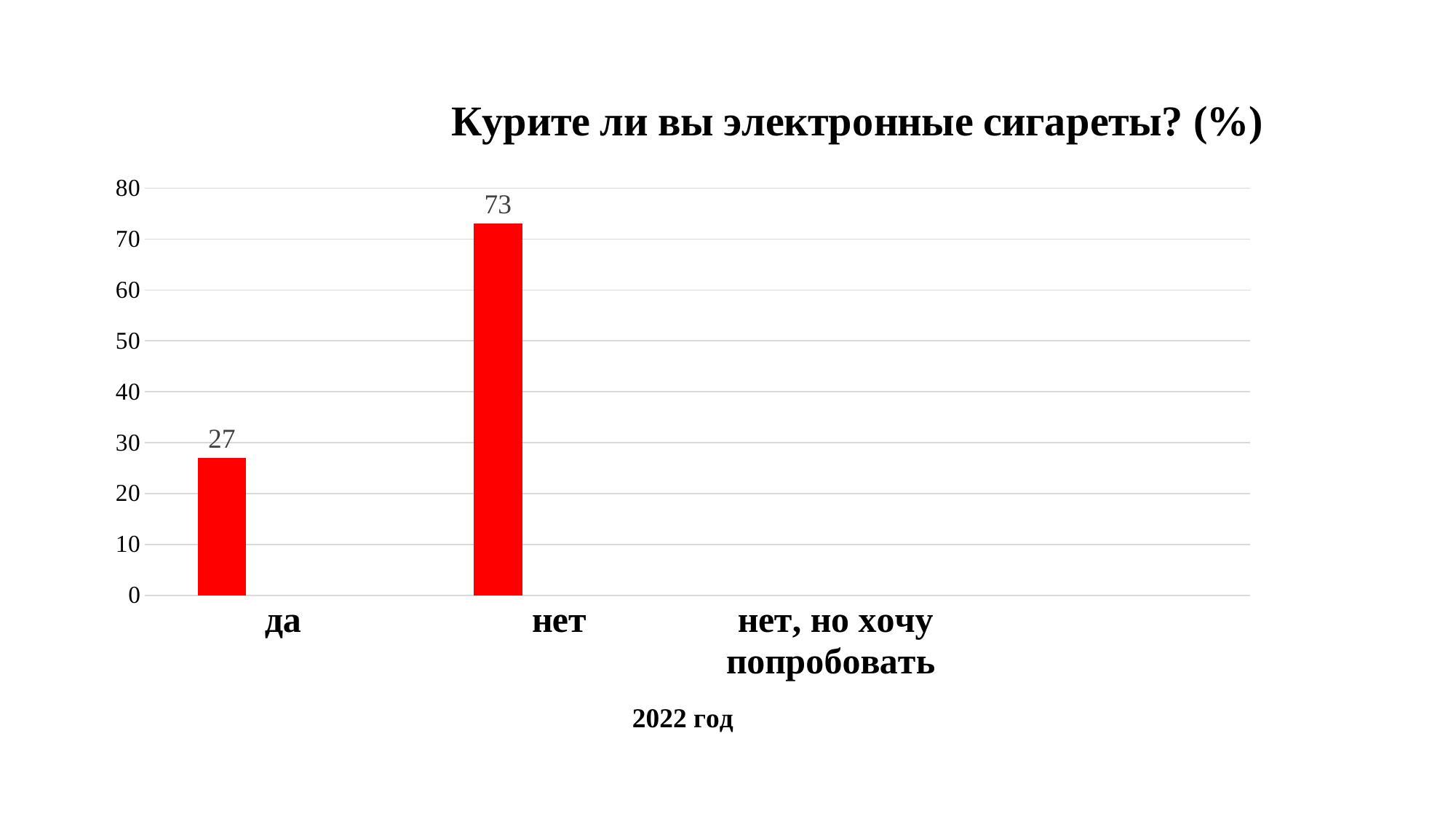
Which of the two plotted categories, "да" or "нет", has the lower value? да Which category has the highest value? нет What kind of chart is shown? bar chart What is the value for "нет"? 73 How many categories are labelled on the x axis? 3 What is the value for "да"? 27 Is the value for "да" greater or less than 30? less What is the title of the chart? Курите ли вы электронные сигареты? (%) Is the value for "нет" greater or less than 70? greater Which is larger, the value for "да" or the value for "нет"? нет What colour are the bars? red What is the difference between the values for "нет" and "да"? 46